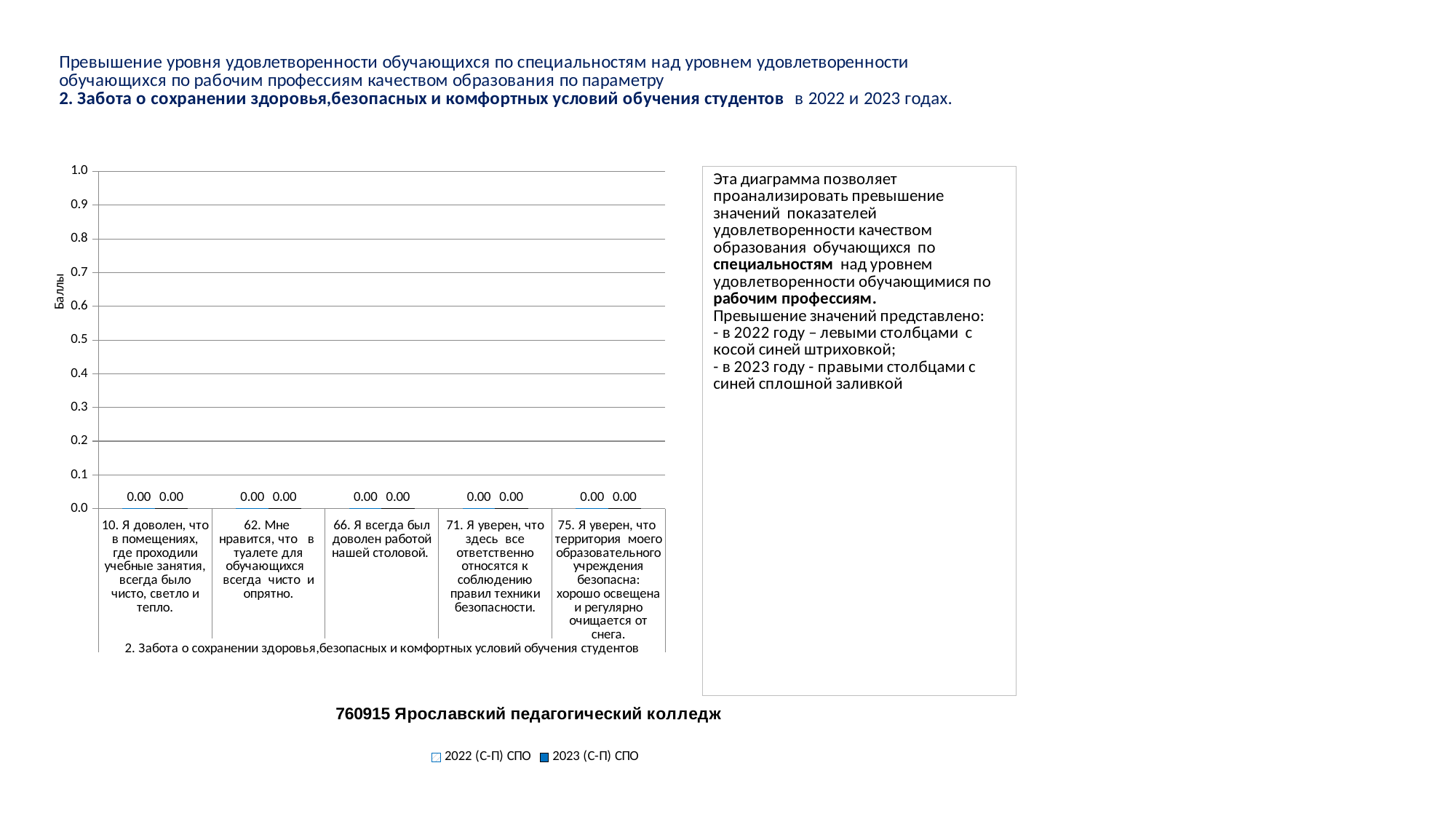
What is the label of the vertical axis of the chart? Баллы What kind of chart is shown on the slide? bar chart Is the value for the 2022 (С-П) СПО series for category 62 greater or less than 0.5? less Do the values rise, fall, or stay the same across the categories along the x axis? stay the same What is the value for the 2023 (С-П) СПО series for category 66 (Я всегда был доволен работой нашей столовой)? 0.00 What is the value for the 2023 (С-П) СПО series for category 71 (Я уверен, что здесь все ответственно относятся к соблюдению правил техники безопасности)? 0.00 What is the value for the 2022 (С-П) СПО series for category 10 (Я доволен, что в помещениях, где проходили учебные занятия, всегда было чисто, светло и тепло)? 0.00 What is the difference between the 2023 (С-П) СПО and 2022 (С-П) СПО values for category 62 (Мне нравится, что в туалете для обучающихся всегда чисто и опрятно)? 0.00 What is the value for the 2022 (С-П) СПО series for category 75 (Я уверен, что территория моего образовательного учреждения безопасна)? 0.00 How many categories (questions) are shown on the x axis of the chart? 5 How many series does the legend list? 2 What are the two series names listed in the legend? 2022 (С-П) СПО and 2023 (С-П) СПО